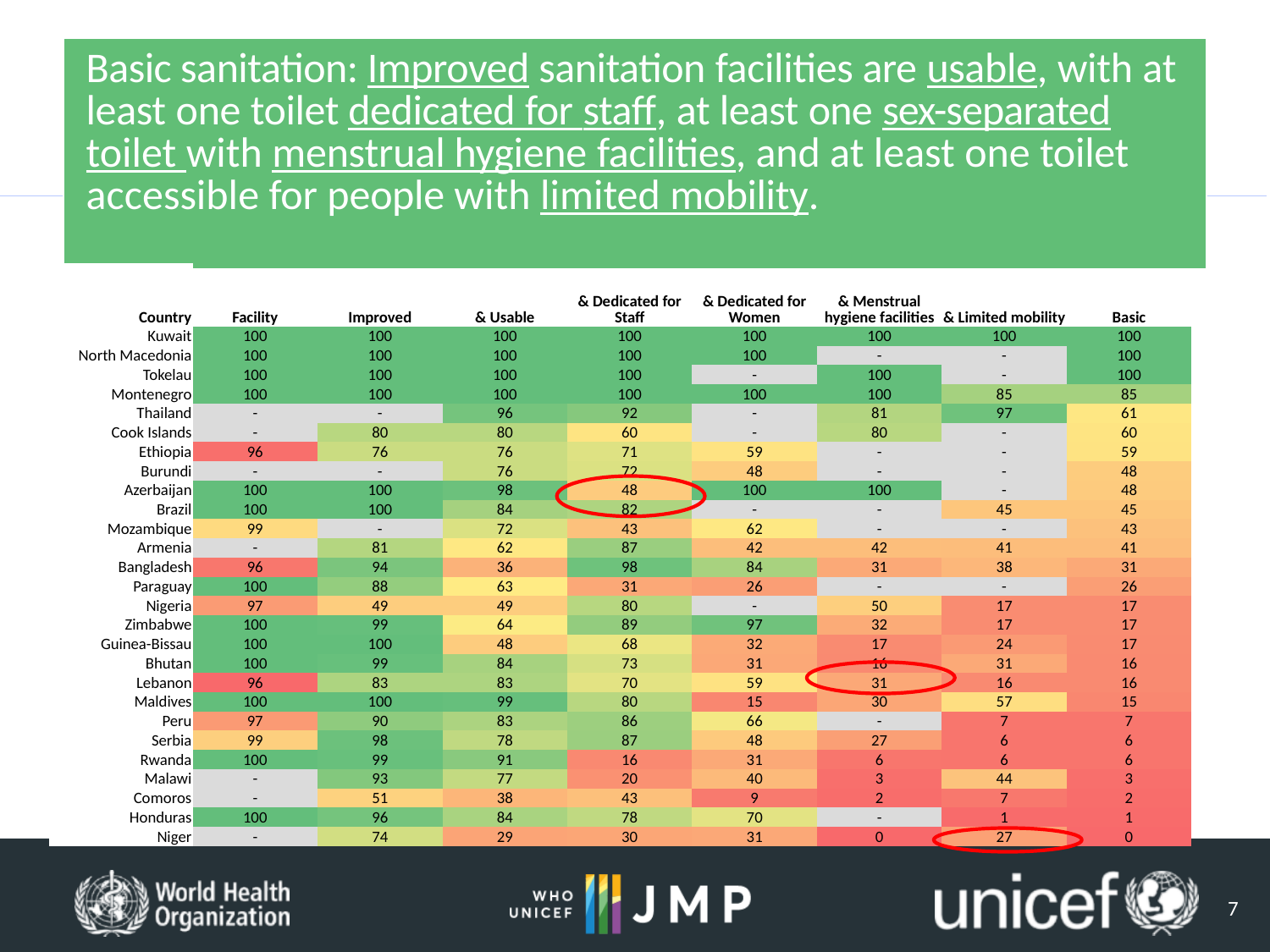
Which country has the lowest Basic value? Niger For Malawi, which is larger: the & Limited mobility value or the & Menstrual hygiene facilities value? & Limited mobility How many data columns (excluding Country) does the table have? 8 What is the & Dedicated for Staff value for Azerbaijan? 48 What is the difference between Bangladesh's & Dedicated for Staff value and its & Usable value? 62 What is the & Limited mobility value for Maldives? 57 Which country has the lowest & Dedicated for Women value? Comoros How many countries are listed in the table? 27 What is the Basic value for Thailand? 61 What is the & Limited mobility value for Niger? 27 What is shown in the & Dedicated for Women cell for Tokelau? - What is the & Menstrual hygiene facilities value for Lebanon? 31